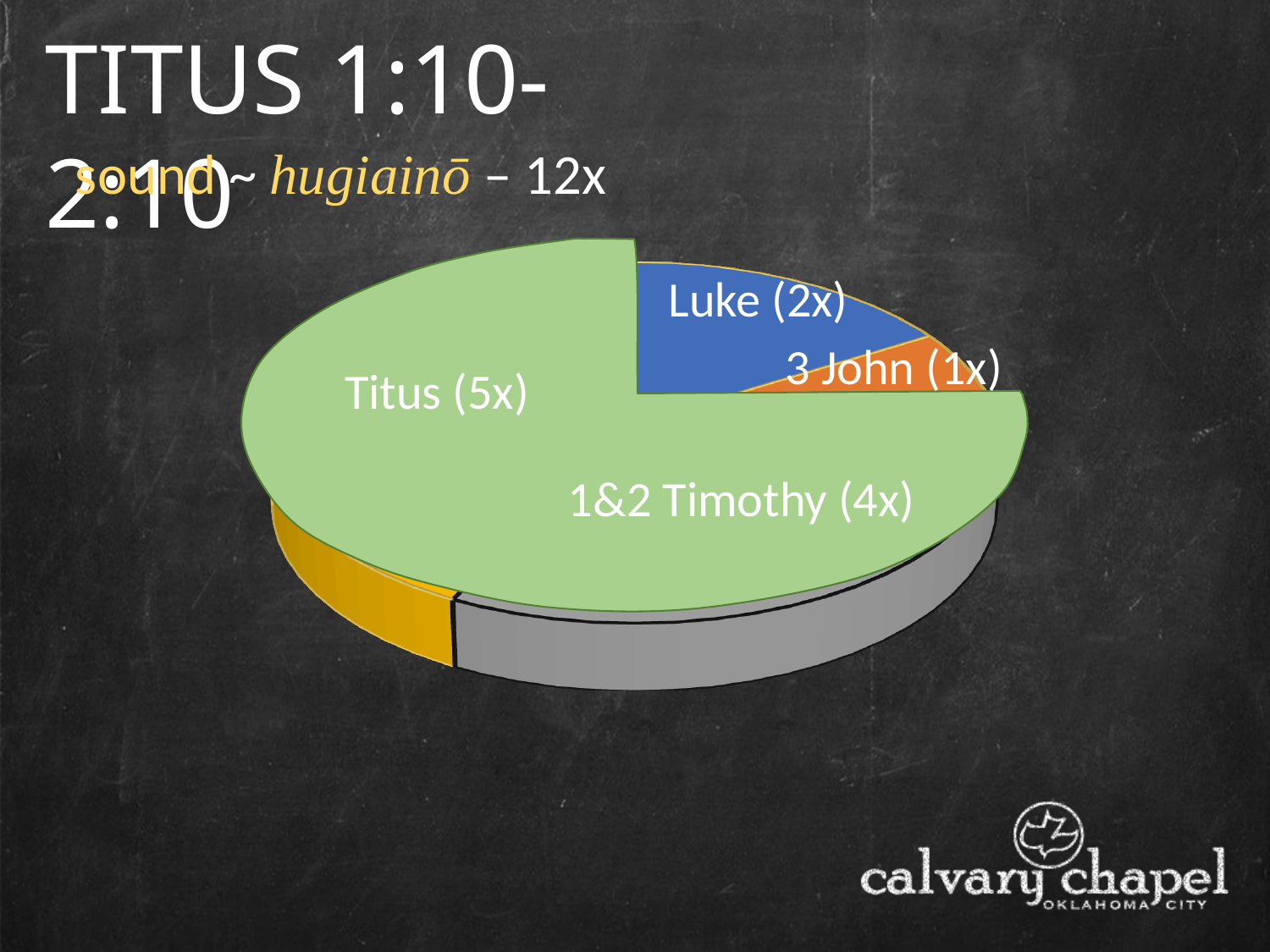
How many slices (categories) does the pie chart have? 4 How many times does the chart show the word occurring in 1&2 Timothy? 4x How many more occurrences does 1&2 Timothy have than 3 John? 3 What kind of chart is shown on the slide? pie chart How many more occurrences does Titus have than Luke? 3 Which book has the smallest slice of the pie chart? 3 John How many times does the chart show the word occurring in Luke? 2x How many times does the chart show the word occurring in Titus? 5x How many times does the chart show the word occurring in 3 John? 1x Which has more occurrences, Titus or 1&2 Timothy? Titus Which book has the largest slice of the pie chart? Titus What is the total number of occurrences across all slices of the pie chart? 12x